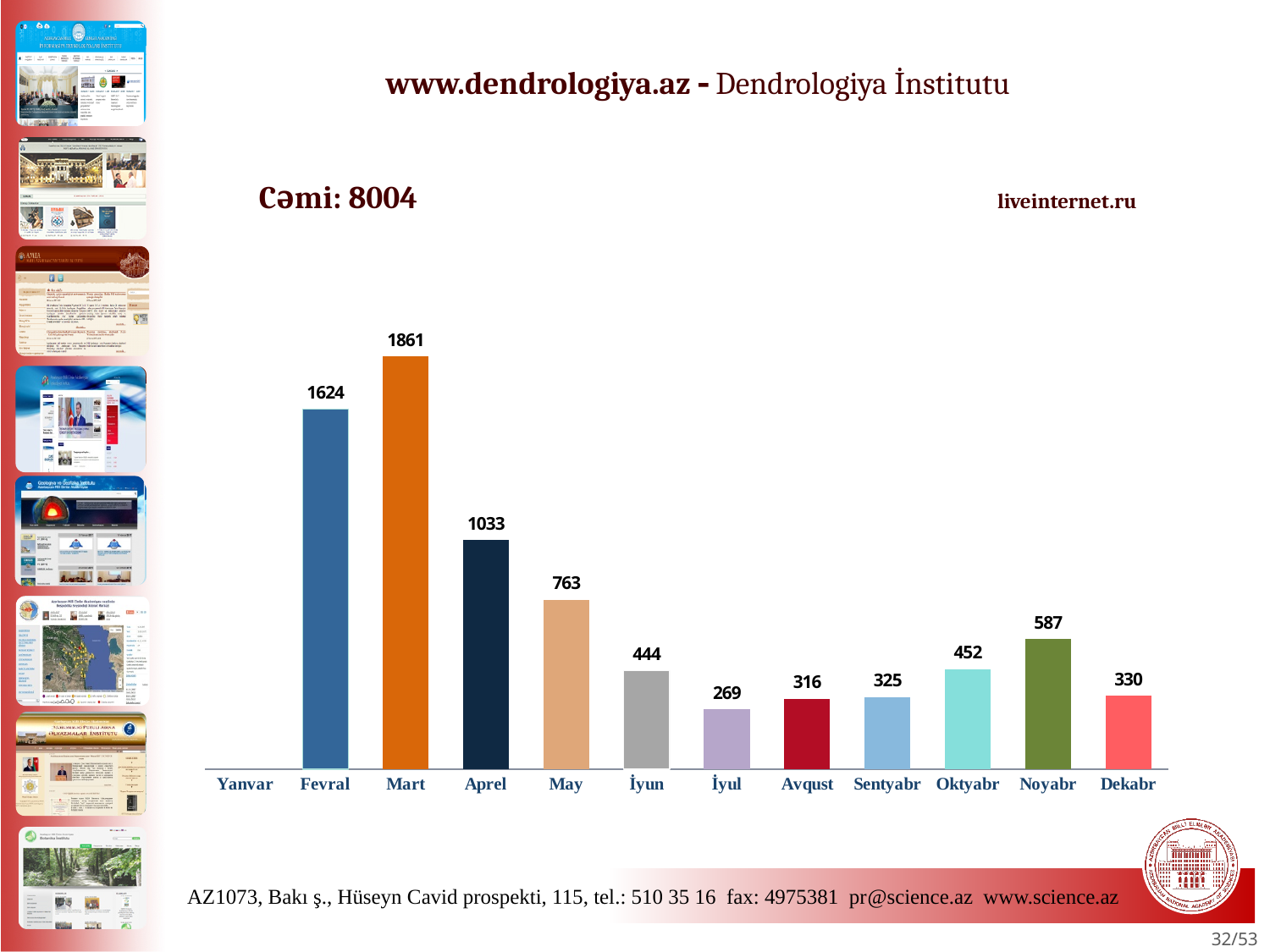
What is the value for Noyabr? 587 What total (Cəmi) is stated on the slide? 8004 Which is larger, the value for Oktyabr or the value for Sentyabr? Oktyabr What is the value for Fevral? 1624 What is the value for Mart? 1861 Among the months with a plotted bar, which has the lowest value? İyul What kind of chart is shown on the slide? Bar chart Do the values rise or fall from Fevral to İyul? Fall What is the difference between the values for Mart and Fevral? 237 How many months are listed on the x axis? 12 Which month has the highest value? Mart What is the value for İyul? 269